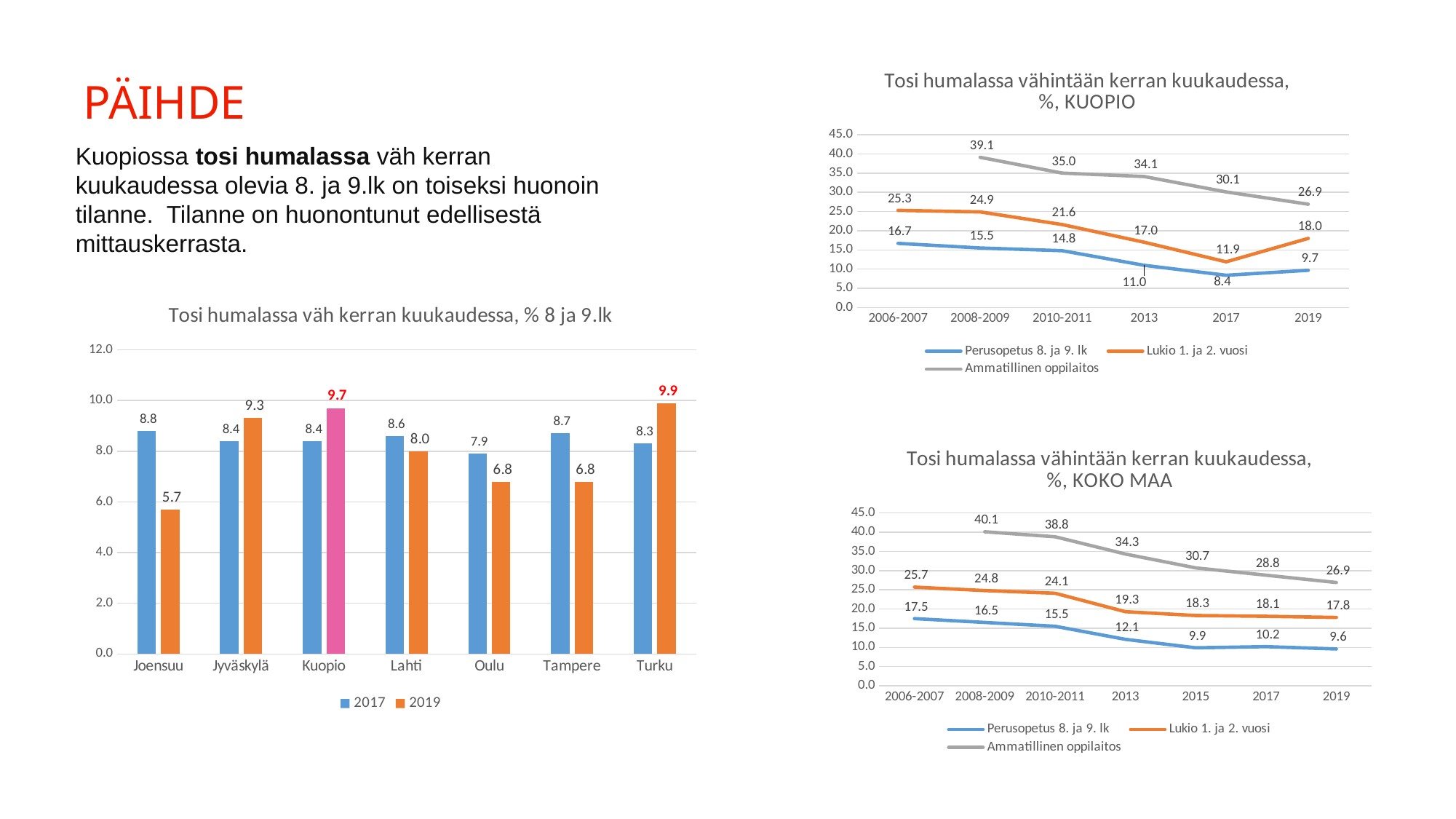
In the bar chart 'Tosi humalassa väh kerran kuukaudessa, % 8 ja 9.lk', how many series does the legend list? 2 In the chart 'Tosi humalassa vähintään kerran kuukaudessa, %, KOKO MAA', what is the value for Perusopetus 8. ja 9. lk in 2015? 9.9 In the bar chart 'Tosi humalassa väh kerran kuukaudessa, % 8 ja 9.lk', what is the 2019 value for Kuopio? 9.7 In the chart 'Tosi humalassa vähintään kerran kuukaudessa, %, KOKO MAA', which is larger in 2019: Lukio 1. ja 2. vuosi or Perusopetus 8. ja 9. lk? Lukio 1. ja 2. vuosi In the bar chart 'Tosi humalassa väh kerran kuukaudessa, % 8 ja 9.lk', which city has the lowest 2019 value? Joensuu In the bar chart 'Tosi humalassa väh kerran kuukaudessa, % 8 ja 9.lk', which city has the highest 2019 value? Turku In the chart 'Tosi humalassa vähintään kerran kuukaudessa, %, KUOPIO', what is the value for Ammatillinen oppilaitos in 2008-2009? 39.1 In the bar chart 'Tosi humalassa väh kerran kuukaudessa, % 8 ja 9.lk', what is the difference between the 2019 and 2017 values for Joensuu? 3.1 In the bar chart 'Tosi humalassa väh kerran kuukaudessa, % 8 ja 9.lk', how many cities are shown? 7 In the chart 'Tosi humalassa vähintään kerran kuukaudessa, %, KUOPIO', does the Ammatillinen oppilaitos series rise or fall from 2008-2009 to 2019? Fall What type of chart is 'Tosi humalassa väh kerran kuukaudessa, % 8 ja 9.lk'? Bar chart In the chart 'Tosi humalassa vähintään kerran kuukaudessa, %, KUOPIO', what is the value for Lukio 1. ja 2. vuosi in 2019? 18.0